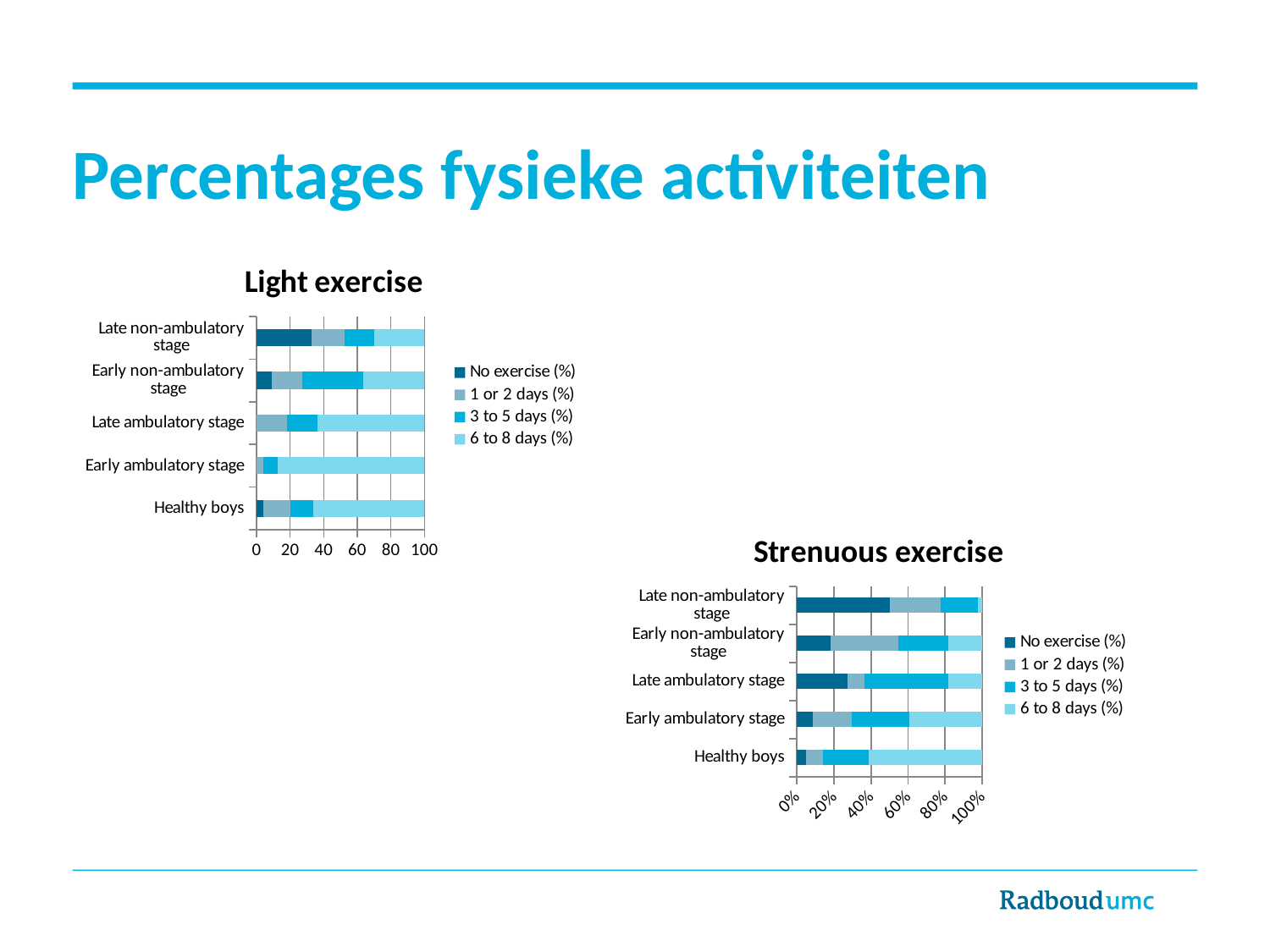
In the "Light exercise" chart, is the "No exercise (%)" value for Late non-ambulatory stage greater or less than 20? greater In the "Strenuous exercise" chart, which legend entry is shown in the darkest blue? No exercise (%) In the "Light exercise" chart, which category has the largest "No exercise (%)" segment? Late non-ambulatory stage In the "Light exercise" chart, which has the larger "6 to 8 days (%)" value: Early ambulatory stage or Late non-ambulatory stage? Early ambulatory stage In the "Strenuous exercise" chart, is the "6 to 8 days (%)" value for Healthy boys greater or less than 40%? greater In the "Strenuous exercise" chart, which has the larger "No exercise (%)" value: Late non-ambulatory stage or Healthy boys? Late non-ambulatory stage What kind of chart is the "Light exercise" chart? Stacked bar chart In the "Strenuous exercise" chart, is the "No exercise (%)" value for Late non-ambulatory stage greater or less than 40%? greater How many categories are shown on the y axis of the "Strenuous exercise" chart? 5 What is the title of the chart on the lower right of the slide? Strenuous exercise How many series does the legend of the "Light exercise" chart list? 4